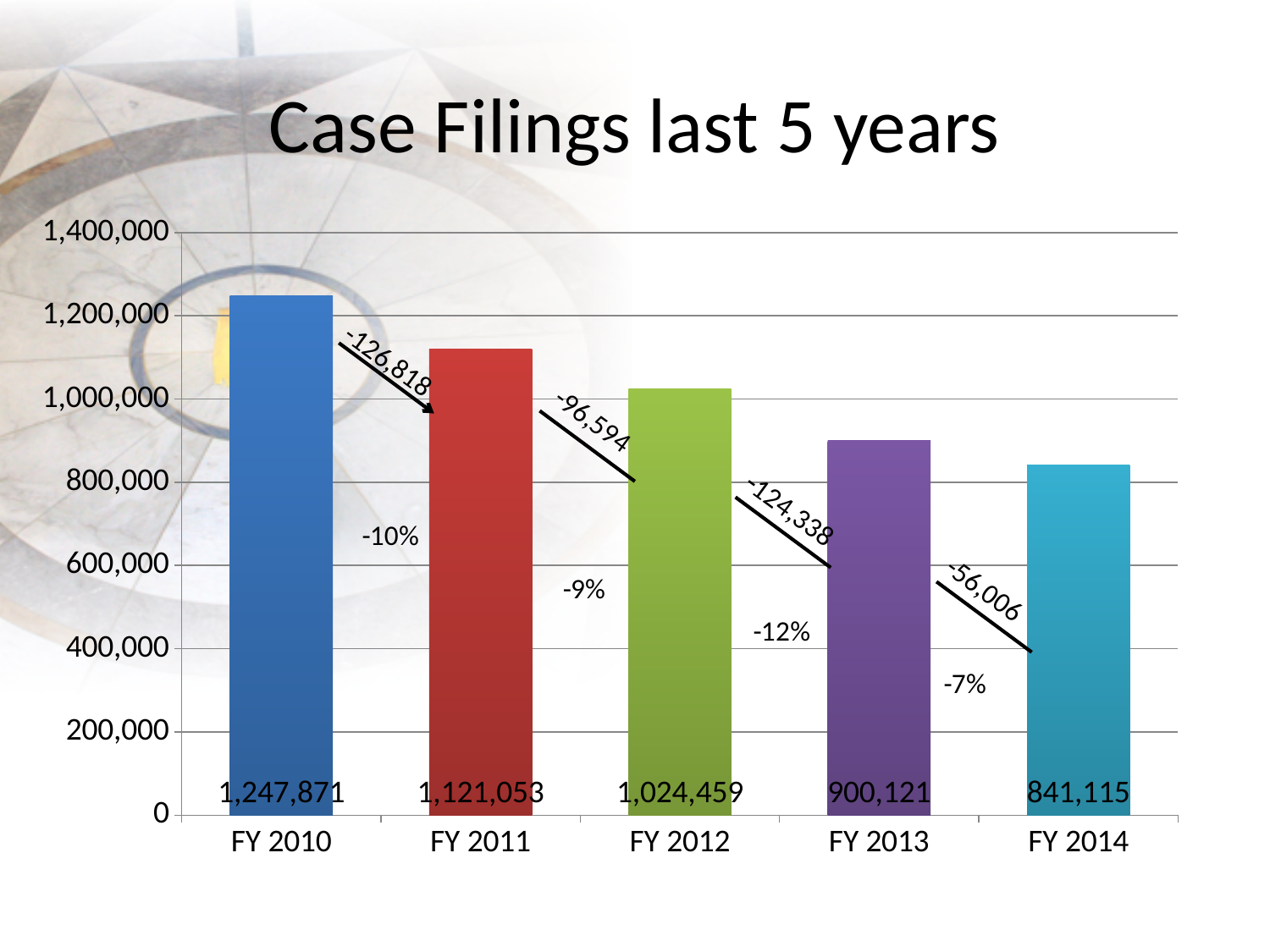
Which fiscal year has the lowest number of case filings? FY 2014 Which is larger, the value for FY 2011 or the value for FY 2013? FY 2011 What is the value for FY 2012? 1,024,459 What is the title of the chart? Case Filings last 5 years How many fiscal years are shown on the x axis? 5 Do the values rise or fall from FY 2010 to FY 2014? Fall What is the value for FY 2010? 1,247,871 Which fiscal year has the highest number of case filings? FY 2010 What is the difference between the FY 2012 and FY 2013 values? 124,338 What is the difference between the FY 2010 and FY 2011 values? 126,818 What is the value for FY 2014? 841,115 What type of chart is shown on the slide? Bar chart